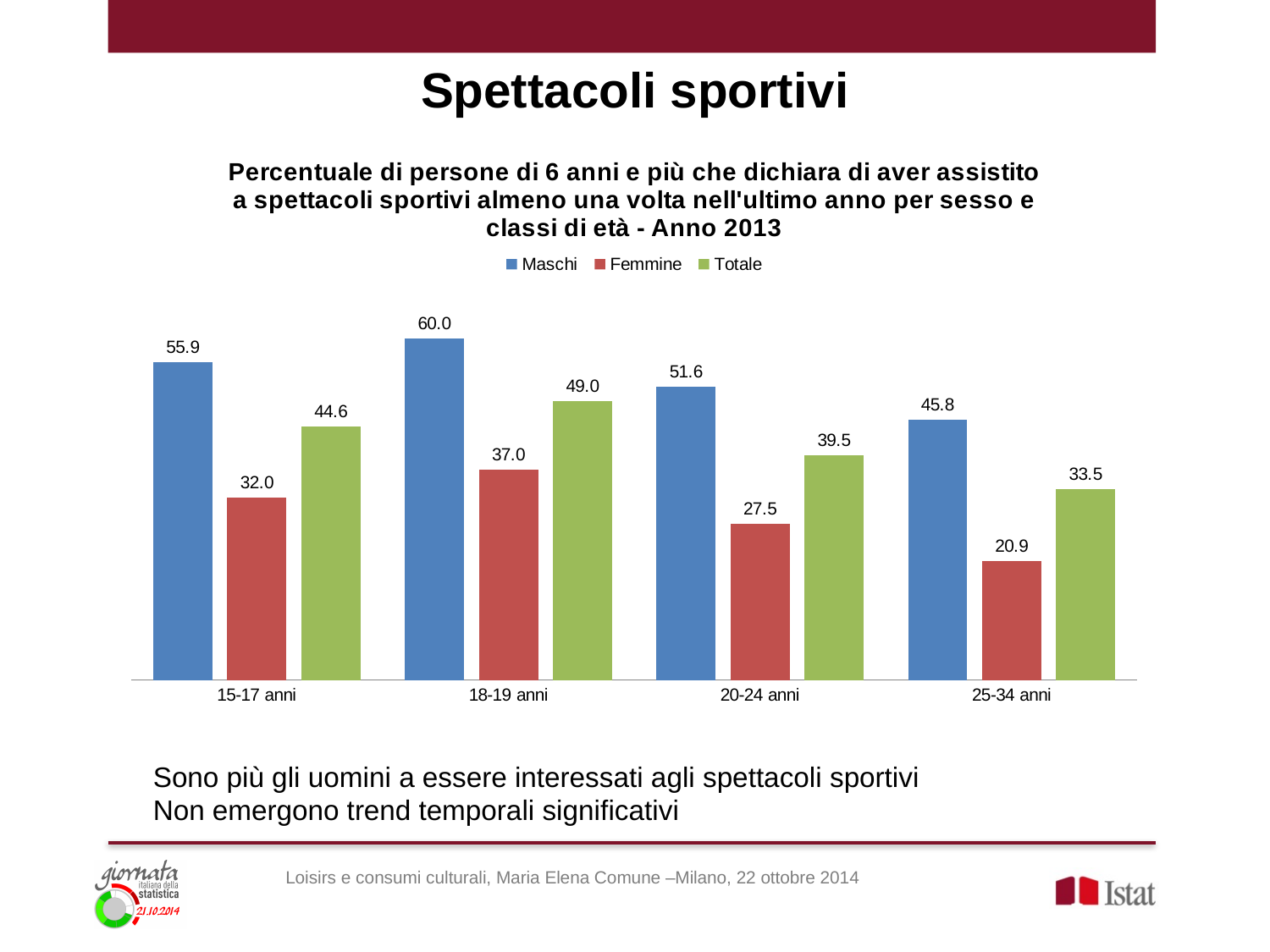
Which colour represents the Totale series in the chart? Green How many series does the legend list? 3 Which age class has the highest value for Maschi? 18-19 anni What is the value for Femmine in the 25-34 anni category? 20.9 What is the value for Totale in the 20-24 anni category? 39.5 What is the difference between the Maschi and Femmine values in the 15-17 anni category? 23.9 What kind of chart is shown on the slide? Bar chart Which is larger: the Totale value for 18-19 anni or the Totale value for 25-34 anni? 18-19 anni What is the value for Maschi in the 18-19 anni category? 60.0 How many age classes are shown on the x axis? 4 Does the Femmine value rise or fall from 20-24 anni to 25-34 anni? Fall Which age class has the lowest value for Femmine? 25-34 anni